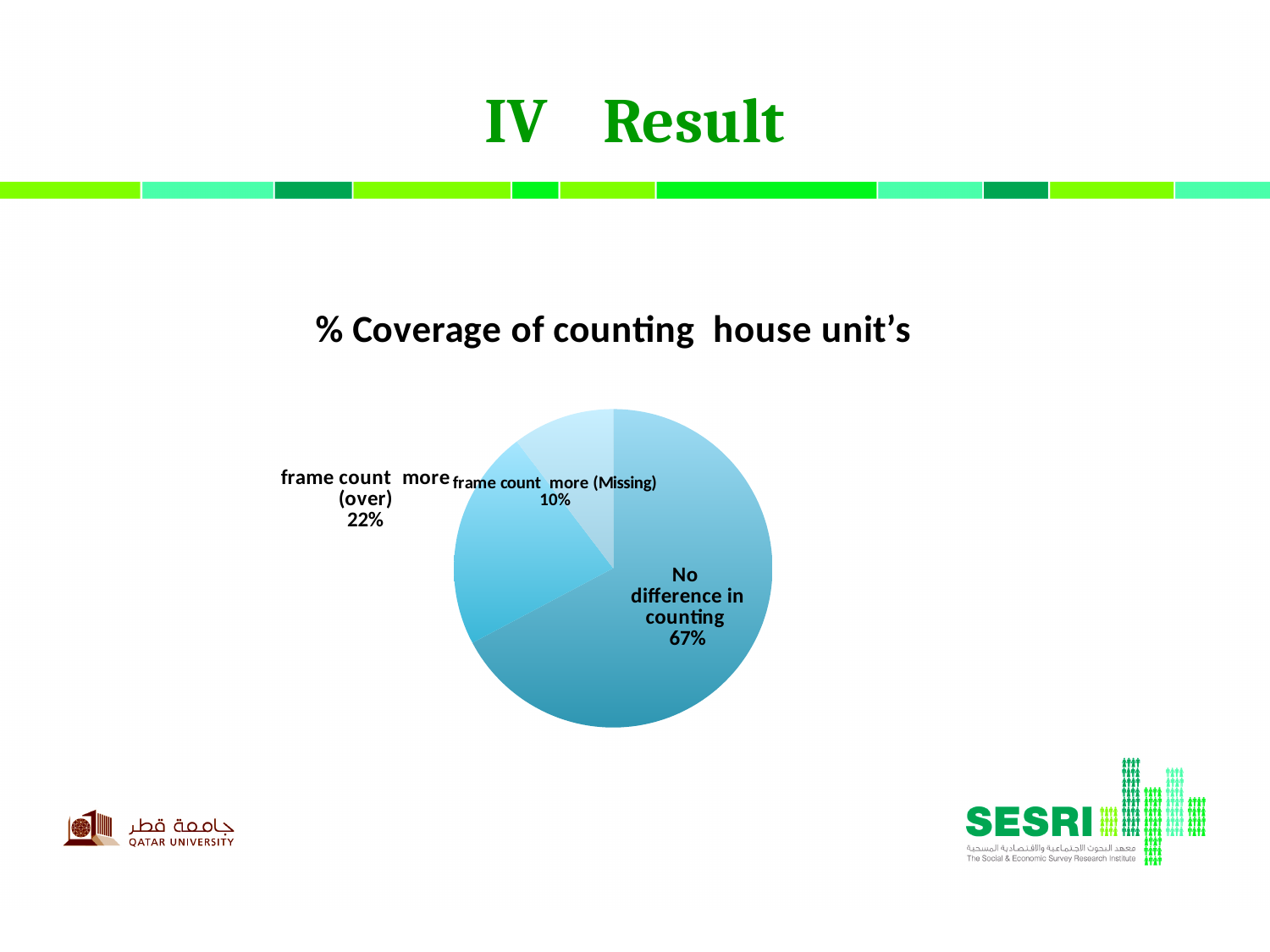
Which slice of the pie is the smallest? frame count more (Missing) What share of the pie does the "No difference in counting" slice represent? 67% What kind of chart is shown on the slide? pie chart What percentage is shown for "frame count more (Missing)"? 10% What is the title of the chart? % Coverage of counting house unit's What is the difference between the "No difference in counting" share and the "frame count more (over)" share? 45% How many slices does the pie chart have? 3 Which is larger: "frame count more (over)" or "frame count more (Missing)"? frame count more (over) What percentage is shown for "No difference in counting"? 67% Which slice of the pie is the largest? No difference in counting What percentage is shown for "frame count more (over)"? 22% What is the difference between the "frame count more (over)" share and the "frame count more (Missing)" share? 12%